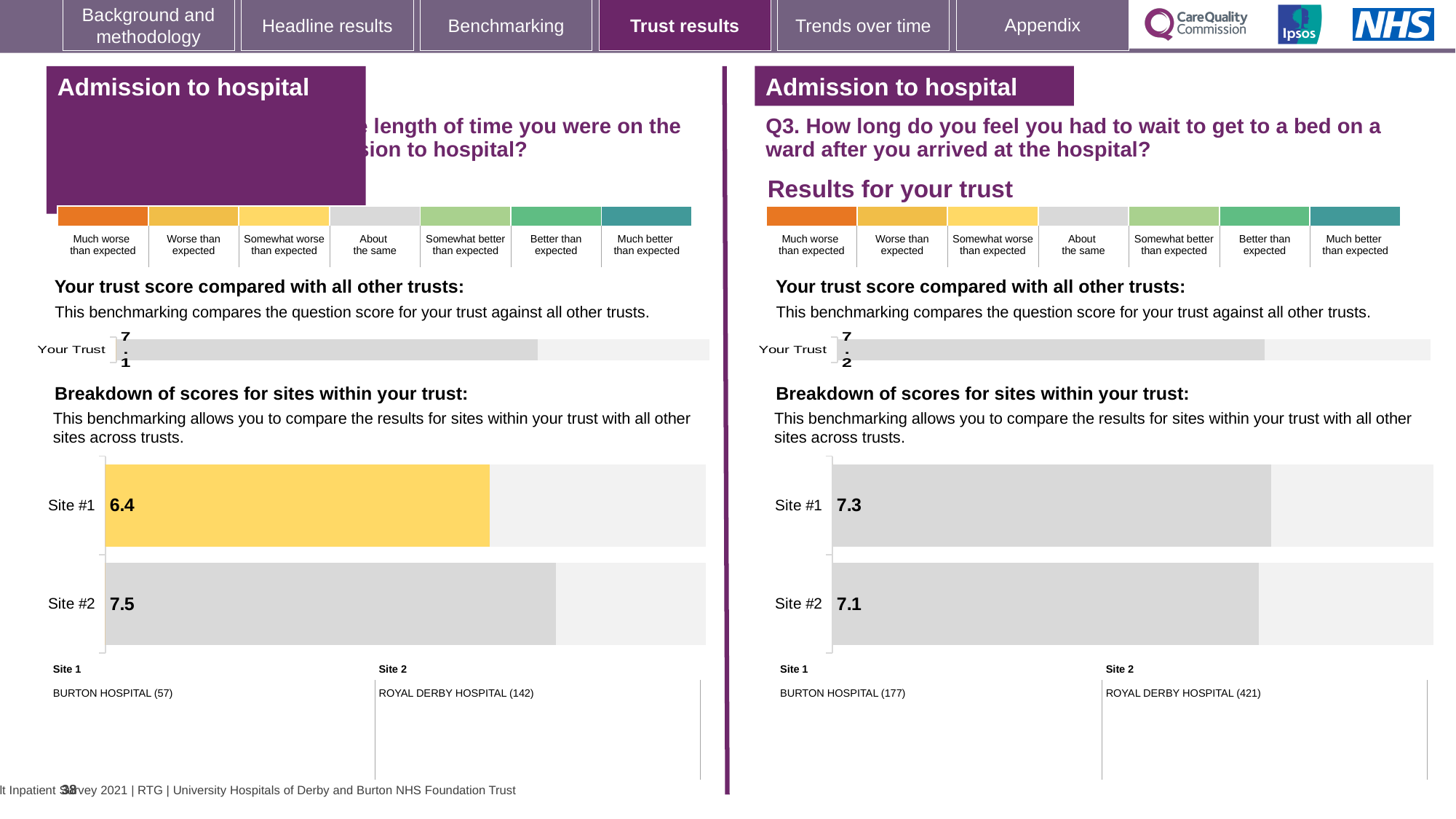
On the left-hand site breakdown chart, what is the difference between the Site #2 and Site #1 scores? 1.1 On the left-hand site breakdown chart, what is the score for Site #1? 6.4 What type of chart is used for the site breakdown on the right-hand side of the slide? Bar chart On the left-hand site breakdown chart, which site has the higher score? Site #2 On the Q3 'Your trust score compared with all other trusts' chart (right-hand side), what is the score for Your Trust? 7.2 On the Q3 site breakdown chart (right-hand side), what is the difference between the Site #1 and Site #2 scores? 0.2 On the Q3 site breakdown chart (right-hand side), what is the score for Site #2? 7.1 On the Q3 site breakdown chart (right-hand side), which site has the lower score? Site #2 How many sites are shown on the left-hand site breakdown chart? 2 On the left-hand site breakdown chart, what is the score for Site #2? 7.5 On the left-hand 'Your trust score compared with all other trusts' chart, what is the score for Your Trust? 7.1 On the Q3 site breakdown chart (right-hand side), what is the score for Site #1? 7.3